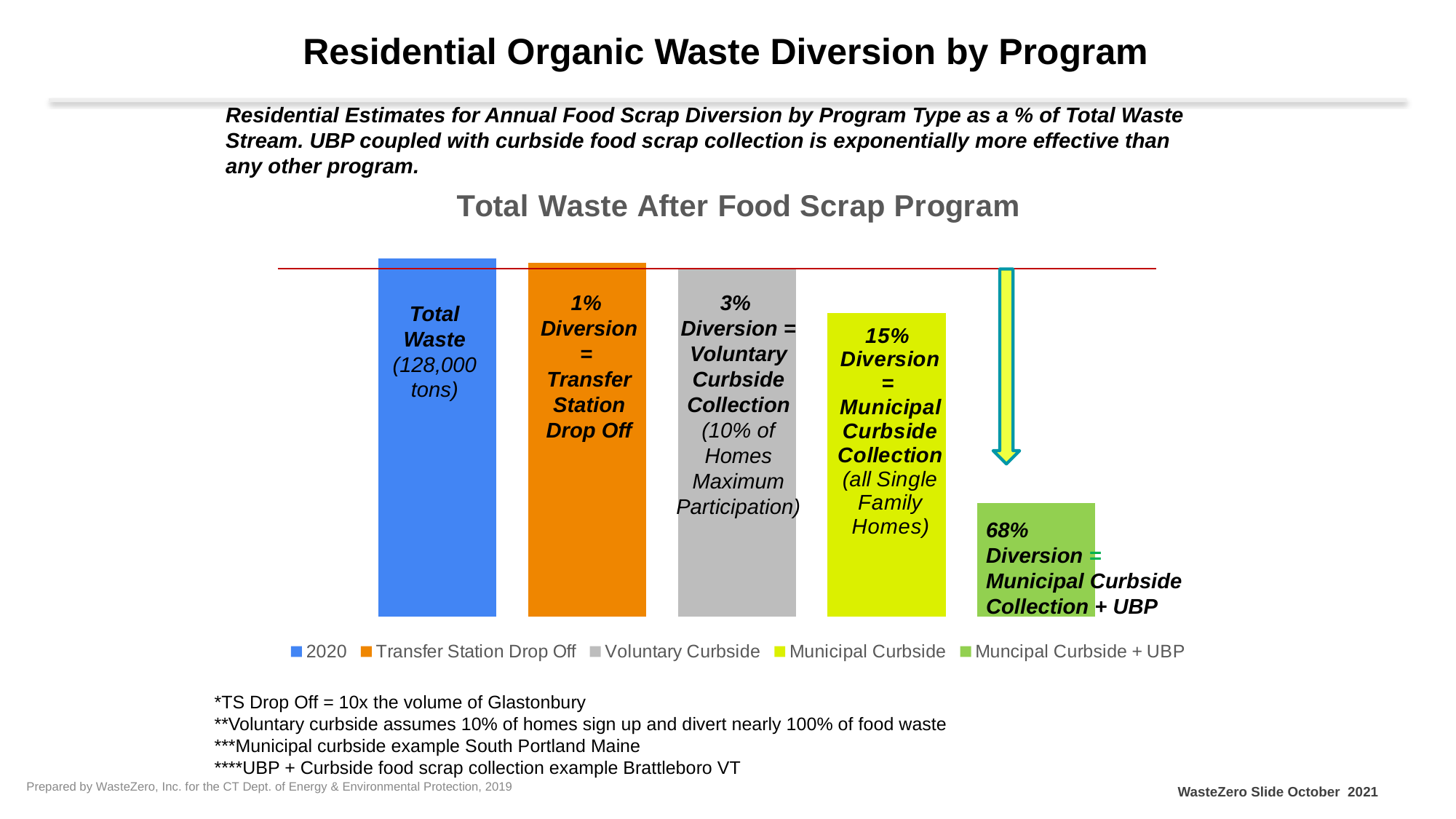
What diversion percentage is printed on the Municipal Curbside + UBP bar? 68% What total waste tonnage is printed on the 2020 bar? 128,000 tons Do the bar heights rise or fall from left to right across the chart? fall What diversion percentage is printed on the Municipal Curbside bar? 15% How many percentage points higher is the diversion for Municipal Curbside + UBP than for Municipal Curbside? 53 Which bar in the chart is the shortest? Muncipal Curbside + UBP Which bar in the chart is the tallest? 2020 How many bars are plotted in the chart? 5 How many entries does the chart legend list? 5 What diversion percentage is printed on the Voluntary Curbside bar? 3% What type of chart is shown under the title "Total Waste After Food Scrap Program"? bar chart What diversion percentage is printed on the Transfer Station Drop Off bar? 1%